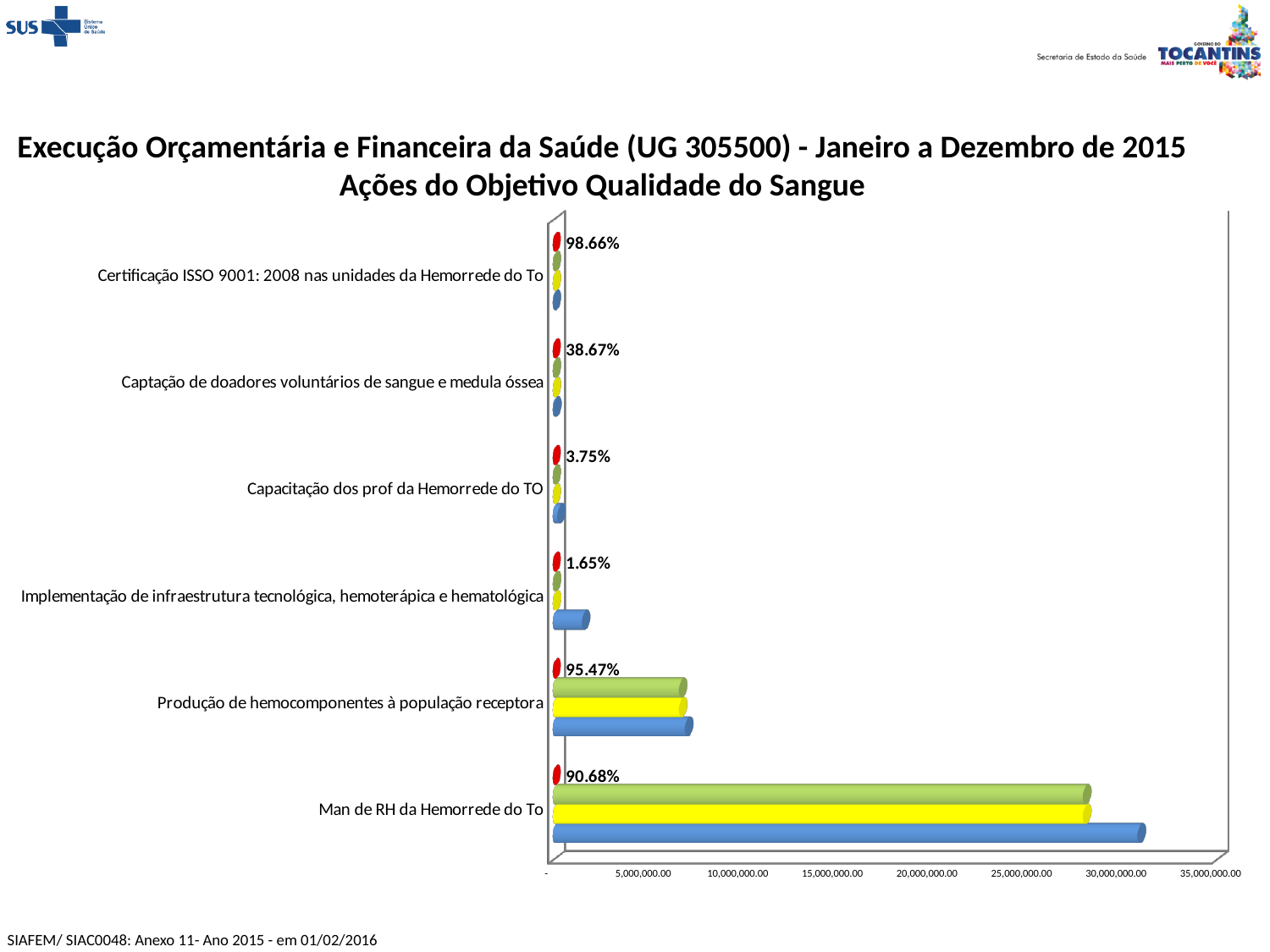
What is the difference between the percentage labels for "Certificação ISSO 9001: 2008 nas unidades da Hemorrede do To" and "Man de RH da Hemorrede do To"? 7.98% What percentage is shown for "Captação de doadores voluntários de sangue e medula óssea"? 38.67% Is the value of the blue bar for "Produção de hemocomponentes à população receptora" greater or less than 10,000,000.00? less Which category has the highest percentage label? Certificação ISSO 9001: 2008 nas unidades da Hemorrede do To Which has a higher percentage label: "Produção de hemocomponentes à população receptora" or "Captação de doadores voluntários de sangue e medula óssea"? Produção de hemocomponentes à população receptora What percentage is shown for "Implementação de infraestrutura tecnológica, hemoterápica e hematológica"? 1.65% Is the value of the blue bar for "Man de RH da Hemorrede do To" greater or less than 30,000,000.00? greater Which category has the lowest percentage label? Implementação de infraestrutura tecnológica, hemoterápica e hematológica What percentage is shown for "Certificação ISSO 9001: 2008 nas unidades da Hemorrede do To"? 98.66% How many categories are shown on the chart? 6 What kind of chart is shown on the slide? Bar chart What percentage is shown for "Man de RH da Hemorrede do To"? 90.68%